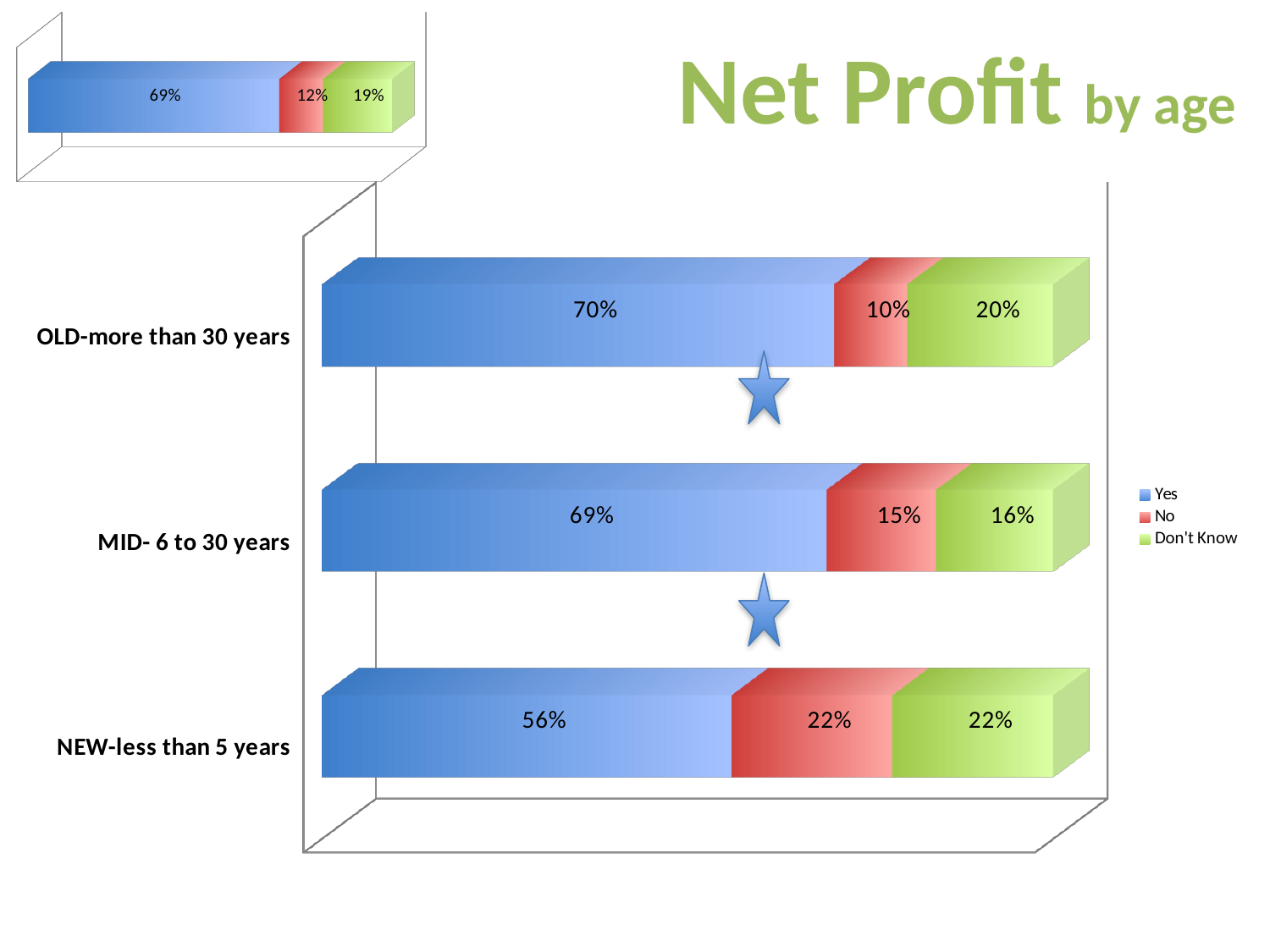
In the Net Profit by age chart, what is the No value for MID- 6 to 30 years? 15% In the Net Profit by age chart, which age group has the lowest No value? OLD-more than 30 years How many age groups are shown in the Net Profit by age chart? 3 In the Net Profit by age chart, what is the Yes value for OLD-more than 30 years? 70% What kind of chart is the Net Profit by age chart? Stacked bar chart How many series does the legend of the Net Profit by age chart list? 3 In the small chart at the top-left of the slide, what value is shown on the red segment? 12% What are the legend entries in the Net Profit by age chart? Yes, No, Don't Know In the Net Profit by age chart, which age group has the highest Yes value? OLD-more than 30 years In the Net Profit by age chart, is the Don't Know value larger for OLD-more than 30 years or for MID- 6 to 30 years? OLD-more than 30 years In the Net Profit by age chart, what is the difference between the Yes values for OLD-more than 30 years and NEW-less than 5 years? 14% In the Net Profit by age chart, what is the Don't Know value for NEW-less than 5 years? 22%